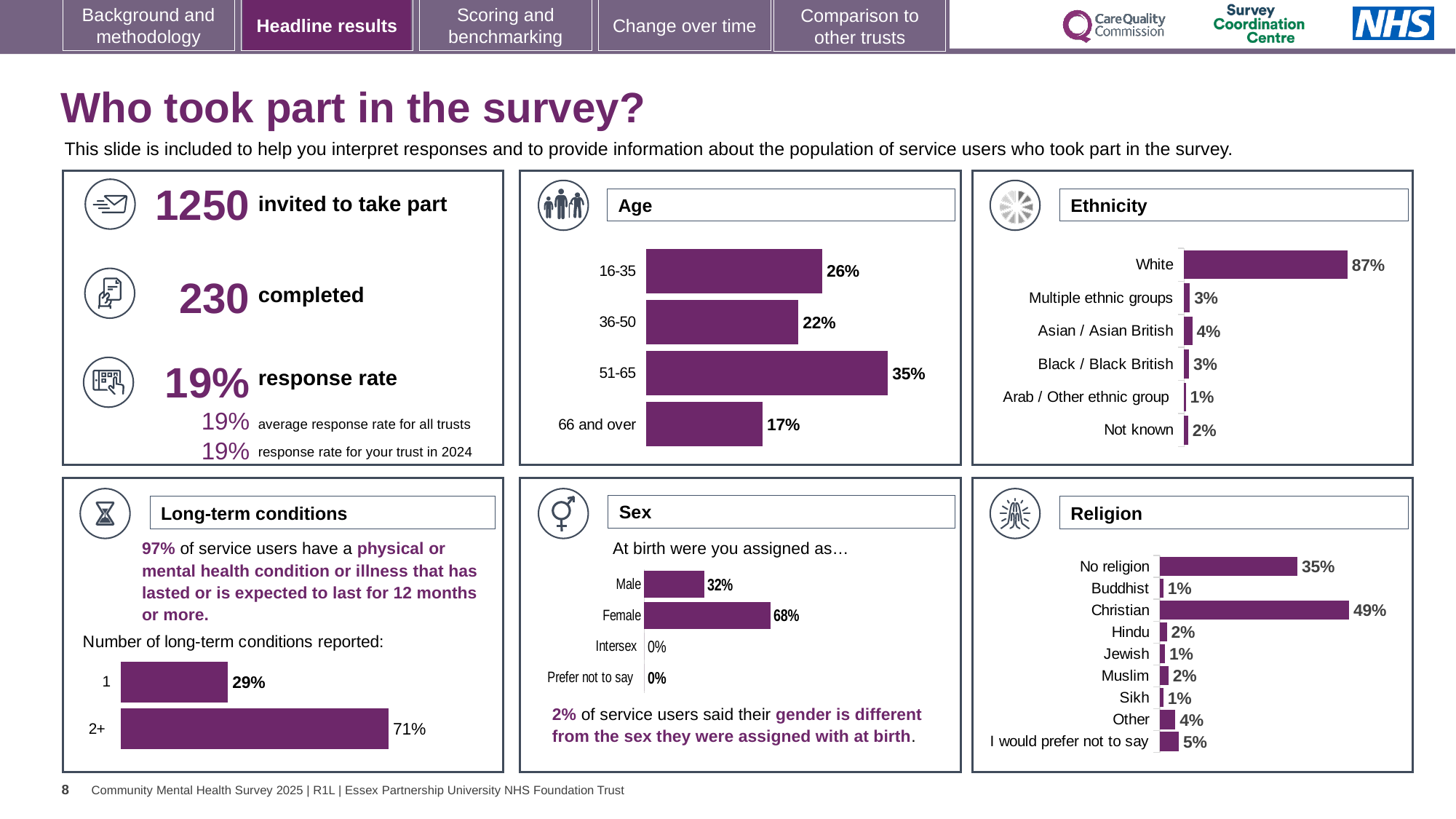
What type of chart is used in the Age panel? bar chart How many categories are shown in the Ethnicity chart? 6 In the Ethnicity chart, which category has the lowest percentage? Arab / Other ethnic group In the Religion chart, is the percentage for No religion larger or smaller than the percentage for Christian? smaller In the Age chart, which age group has the lowest percentage? 66 and over In the Long-term conditions chart, what percentage of service users reported 2+ long-term conditions? 71% In the Age chart, what percentage of respondents were aged 51-65? 35% In the Age chart, what is the difference between the 16-35 and 36-50 percentages? 4% In the Sex chart, what percentage of respondents were assigned Female at birth? 68% In the Religion chart, which religion category has the highest percentage? Christian In the Sex chart, what is the difference between the Female and Male percentages? 36% In the Ethnicity chart, what percentage of respondents were White? 87%